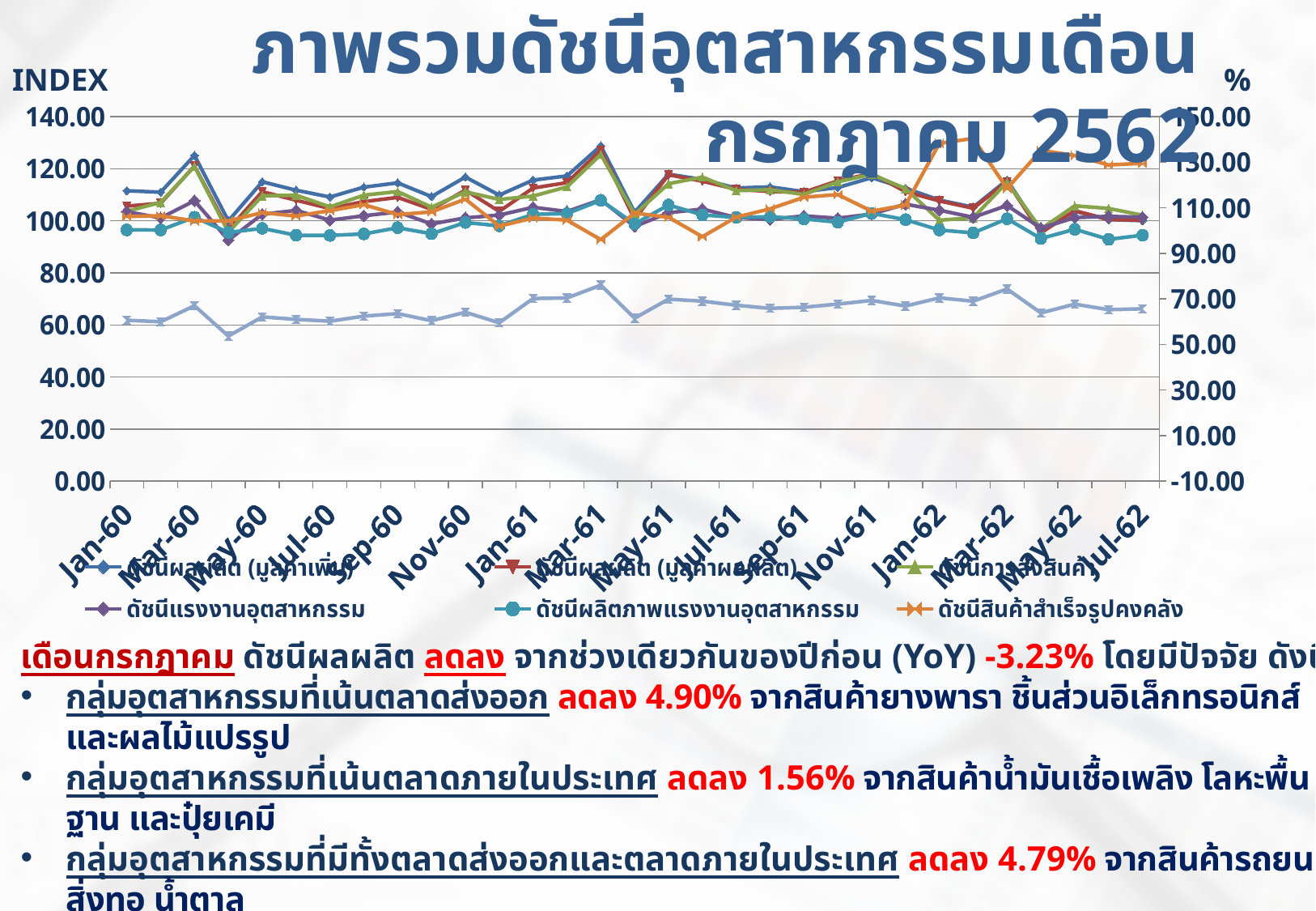
What is the title of the chart? ภาพรวมดัชนีอุตสาหกรรมเดือนกรกฎาคม 2562 Is the value for ดัชนีผลผลิต (มูลค่าเพิ่ม) at Mar-60 greater or less than 120.00 on the left axis? greater At Mar-62, which is larger: ดัชนีสินค้าสำเร็จรูปคงคลัง or ดัชนีแรงงานอุตสาหกรรม? ดัชนีสินค้าสำเร็จรูปคงคลัง Is the value for ดัชนีผลิตภาพแรงงานอุตสาหกรรม at Jan-60 greater or less than 100.00 on the left axis? less Does ดัชนีผลิตภาพแรงงานอุตสาหกรรม rise or fall from Mar-62 to May-62? fall What is the label of the left vertical axis? INDEX What kind of chart is shown on the slide? line chart How many month labels are shown along the x axis? 16 Does ดัชนีสินค้าสำเร็จรูปคงคลัง rise or fall from Nov-61 to Mar-62? rise Is the value for ดัชนีสินค้าสำเร็จรูปคงคลัง at Mar-62 greater or less than 120.00 on the left axis? less At Mar-60, which is larger: ดัชนีผลผลิต (มูลค่าเพิ่ม) or ดัชนีผลิตภาพแรงงานอุตสาหกรรม? ดัชนีผลผลิต (มูลค่าเพิ่ม)